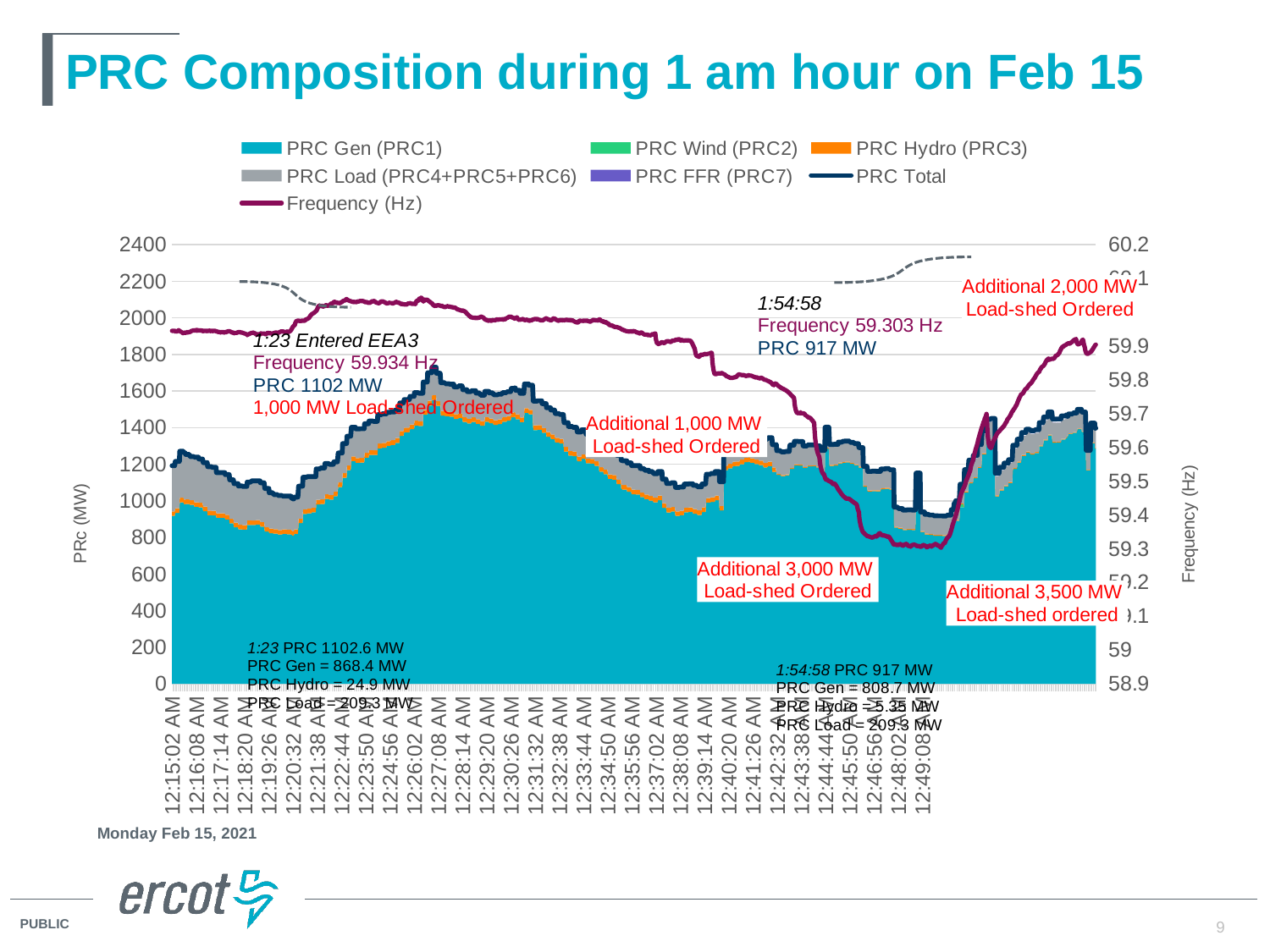
What was the frequency when ERCOT entered EEA3 at 1:23? 59.934 Hz What was PRC Hydro at 1:23? 24.9 MW What was PRC Gen at 1:54:58? 808.7 MW What was the PRC value at 1:54:58? 917 MW What is the label of the right-hand vertical axis? Frequency (Hz) Which was larger, PRC Gen at 1:23 or PRC Gen at 1:54:58? PRC Gen at 1:23 By how much did PRC fall from 1:23 (1102 MW) to 1:54:58 (917 MW)? 185 MW What was the frequency at 1:54:58? 59.303 Hz What was PRC Gen at 1:23? 868.4 MW How much load-shed was ordered in the first order at 1:23? 1,000 MW What kind of chart is shown on the slide? stacked area chart with line overlays How many series does the legend list? 7